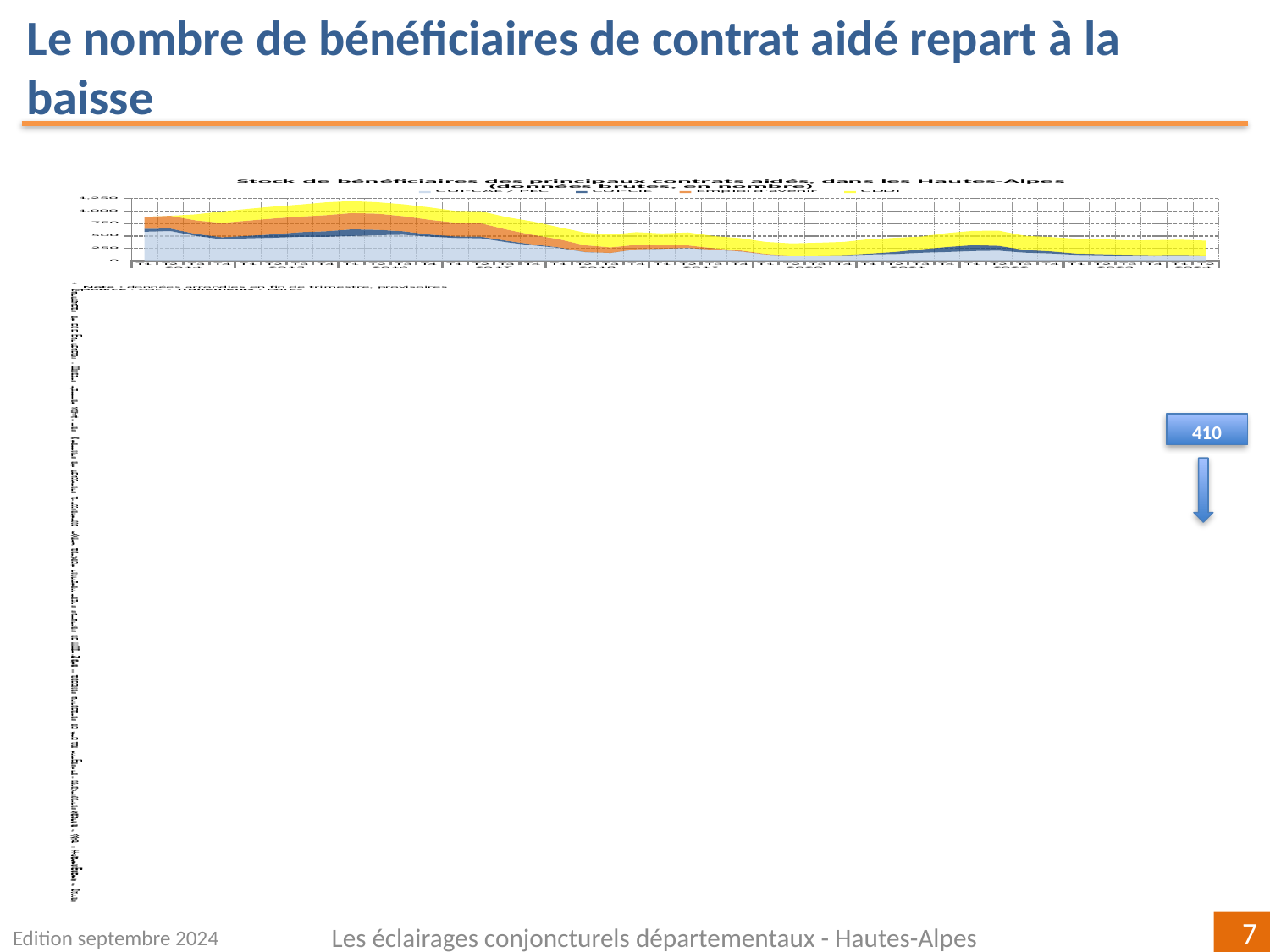
What kind of chart is shown on the slide? area chart Is the total stacked value in 2020 greater or less than 500? less Is the total stacked value at the start of 2014 greater or less than 500? greater Is the total stacked value in 2016 greater or less than 750? greater How many years are labelled along the x axis of the chart? 11 How many series does the chart legend list? 4 Which series are listed in the chart legend? CUI-CAE / PEC, CUI-CIE, Emploi d'avenir, CDDI Overall, do the total stacked values rise or fall from 2014 to 2024? fall In which year does the total stacked value reach its highest level? 2016 What number is shown in the blue callout box next to the chart? 410 What is the title of the chart? Stock de bénéficiaires des principaux contrats aidés, dans les Hautes-Alpes (données brutes, en nombre)